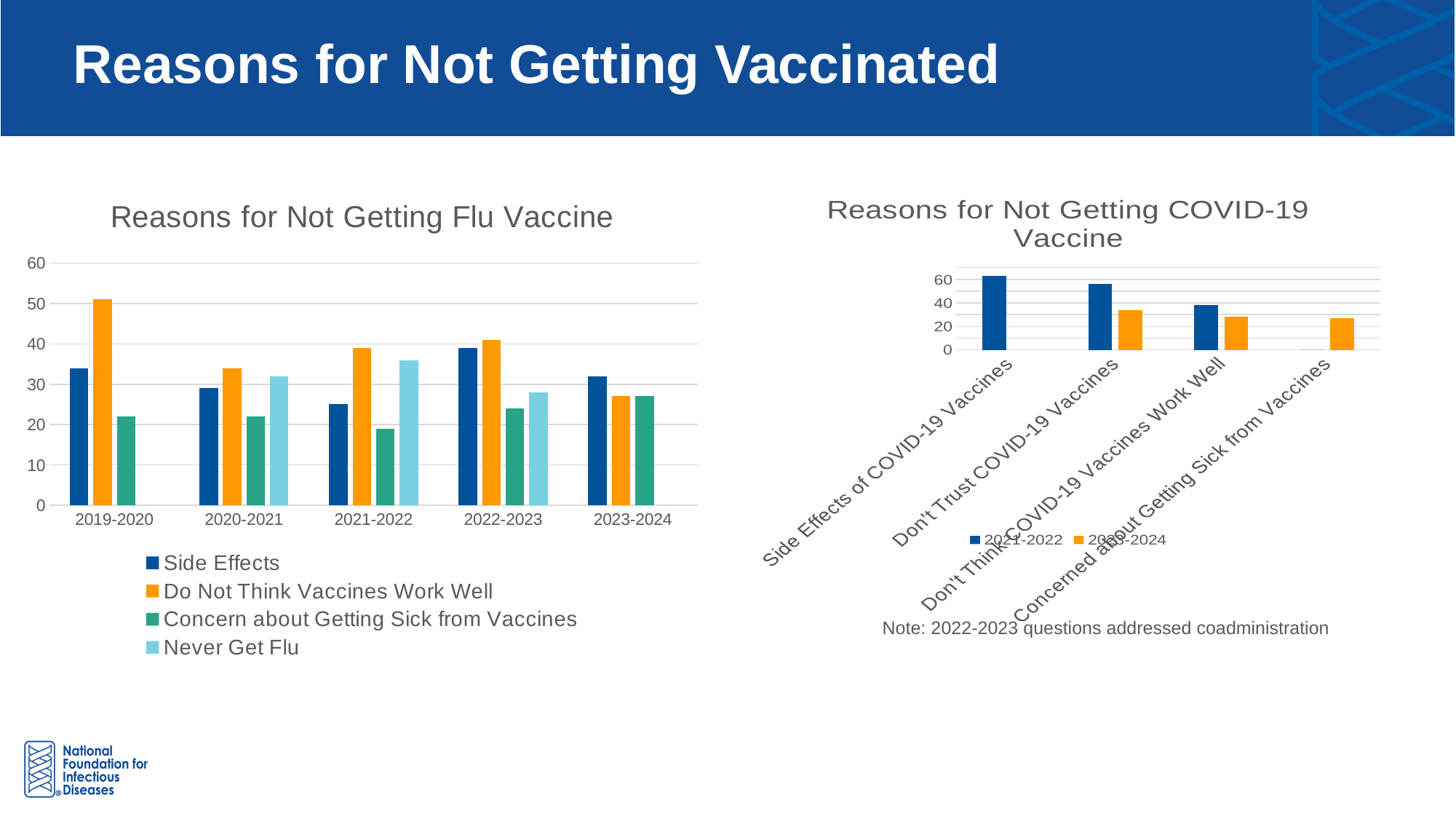
In the 'Reasons for Not Getting Flu Vaccine' chart, does the value for 'Do Not Think Vaccines Work Well' rise or fall from 2022-2023 to 2023-2024? fall In the 'Reasons for Not Getting Flu Vaccine' chart, is the value for 'Do Not Think Vaccines Work Well' in 2019-2020 greater or less than 40? greater What kind of chart is the 'Reasons for Not Getting COVID-19 Vaccine' chart? bar chart In the 'Reasons for Not Getting Flu Vaccine' chart, how many series does the legend list? 4 In the 'Reasons for Not Getting COVID-19 Vaccine' chart, how many series does the legend list? 2 In the 'Reasons for Not Getting Flu Vaccine' chart, how many seasons are shown on the x axis? 5 In the 'Reasons for Not Getting Flu Vaccine' chart, which reason has the highest value in 2019-2020? Do Not Think Vaccines Work Well In the 'Reasons for Not Getting COVID-19 Vaccine' chart, is the 2021-2022 value for 'Side Effects of COVID-19 Vaccines' greater or less than 40? greater What kind of chart is the 'Reasons for Not Getting Flu Vaccine' chart? bar chart In the 'Reasons for Not Getting COVID-19 Vaccine' chart, which reason has the highest value for 2021-2022? Side Effects of COVID-19 Vaccines In the 'Reasons for Not Getting Flu Vaccine' chart, which is larger in 2021-2022: 'Never Get Flu' or 'Side Effects'? Never Get Flu In the 'Reasons for Not Getting Flu Vaccine' chart, is the value for 'Concern about Getting Sick from Vaccines' in 2020-2021 greater or less than 30? less